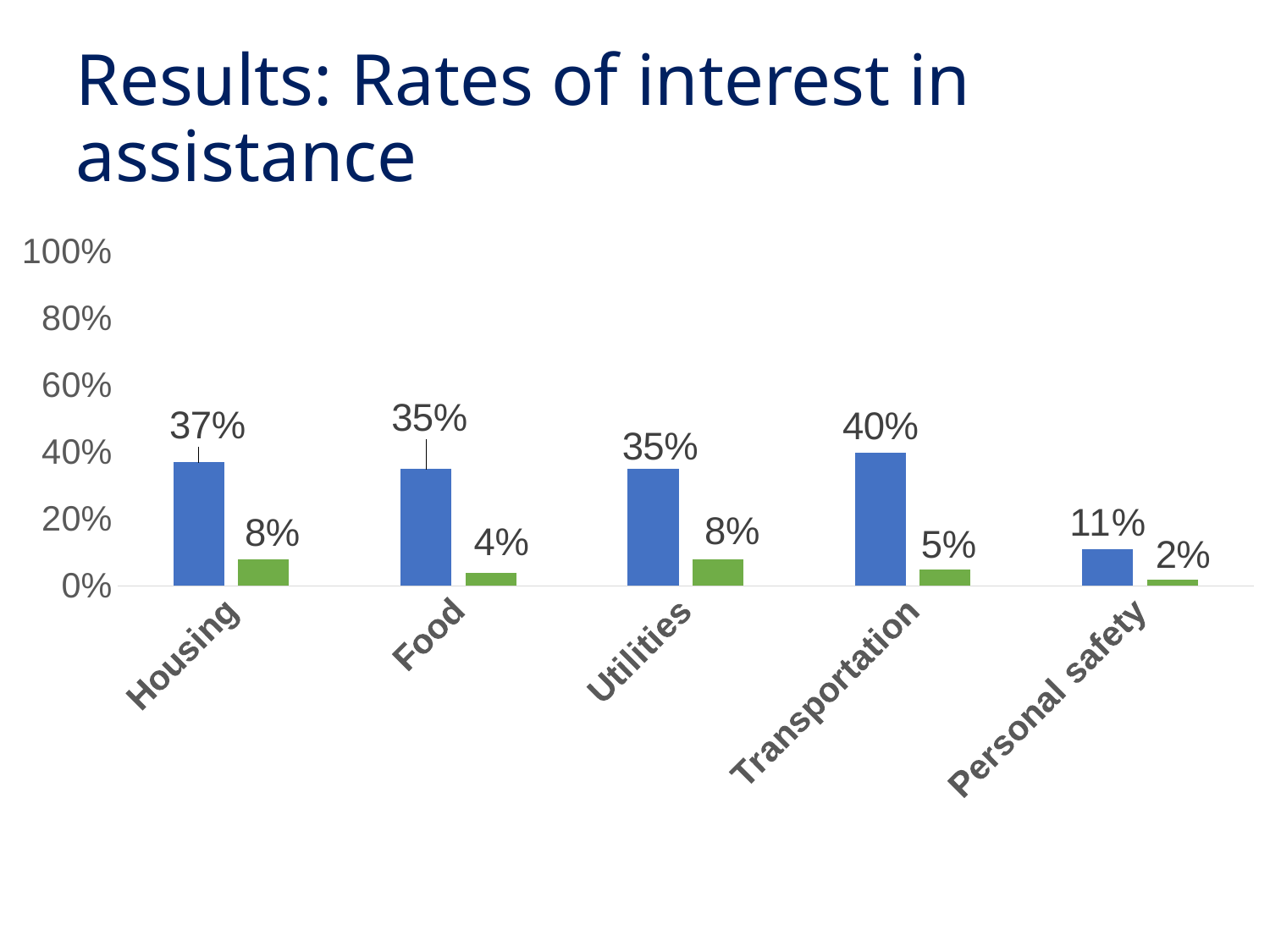
Which is larger, the green bar for Utilities or the green bar for Food? Utilities What kind of chart is shown on the slide? Bar chart What is the value of the blue bar for Personal safety? 11% What is the title of the slide containing the chart? Results: Rates of interest in assistance What is the value of the blue bar for Housing? 37% What is the value of the green bar for Food? 4% What is the difference between the blue bars for Housing and Personal safety? 26% How many categories are shown on the x axis? 5 Which category has the highest blue bar? Transportation What is the value of the green bar for Transportation? 5% What is the difference between the blue bar and the green bar for Transportation? 35% Which category has the lowest green bar? Personal safety